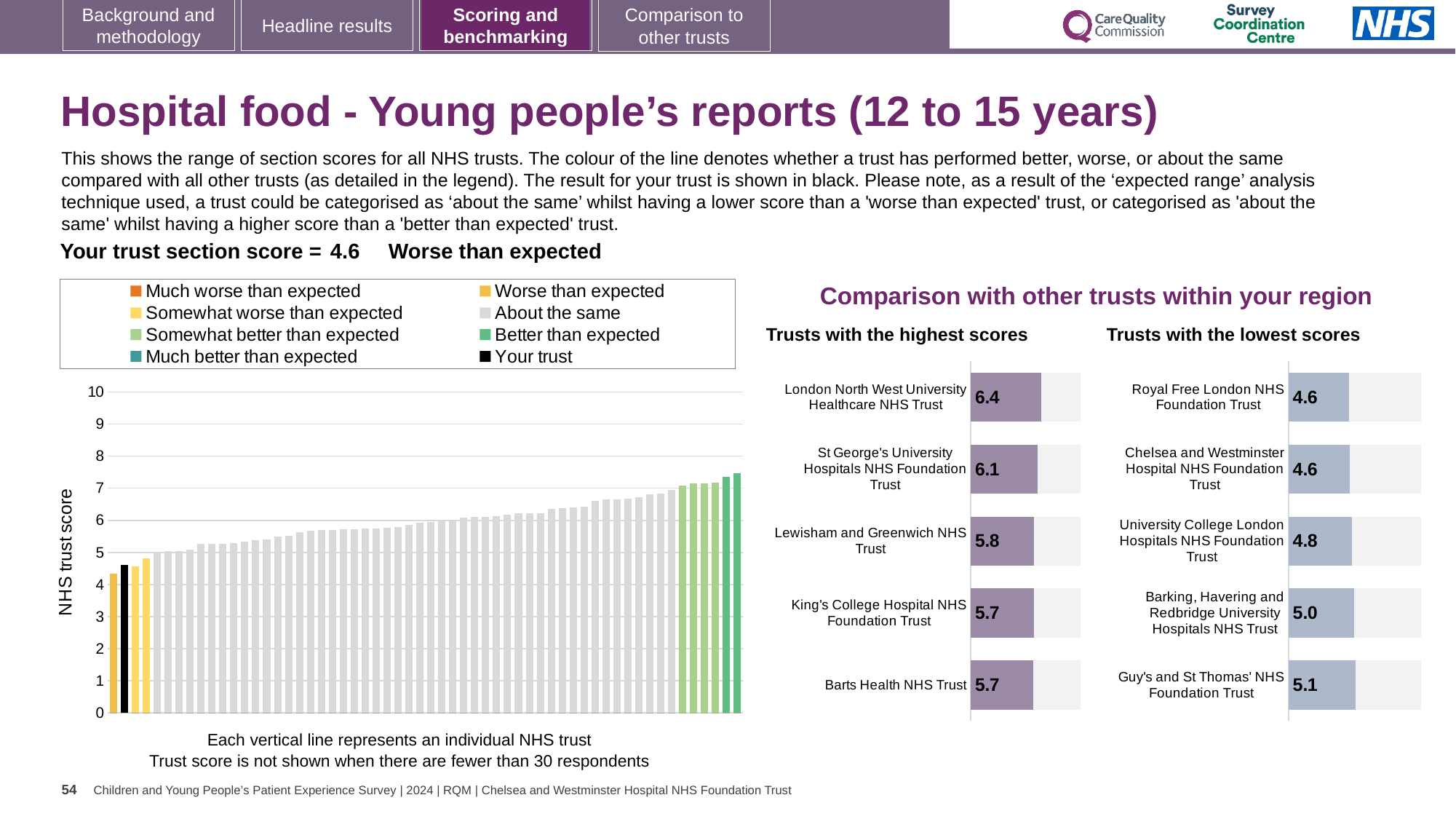
In the 'Trusts with the highest scores' chart, what is the difference between the scores of London North West University Healthcare NHS Trust and Barts Health NHS Trust? 0.7 How many entries does the legend above the NHS trust score chart list? 8 In the 'Trusts with the lowest scores' chart, what is the score for University College London Hospitals NHS Foundation Trust? 4.8 In the 'Trusts with the lowest scores' chart, what is the difference between the scores of Guy's and St Thomas' NHS Foundation Trust and Royal Free London NHS Foundation Trust? 0.5 In the 'Trusts with the highest scores' chart, what is the score for London North West University Healthcare NHS Trust? 6.4 In the NHS trust score chart on the left, is the value for the black 'Your trust' bar greater or less than 5? less In the 'Trusts with the lowest scores' chart, how many trusts are shown? 5 In the 'Trusts with the highest scores' chart, which trust has the highest score? London North West University Healthcare NHS Trust In the 'Trusts with the highest scores' chart, which has a higher score: St George's University Hospitals NHS Foundation Trust or Lewisham and Greenwich NHS Trust? St George's University Hospitals NHS Foundation Trust What kind of chart is the NHS trust score chart on the left? bar chart In the NHS trust score chart on the left, do the bar values rise or fall from left to right? rise In the 'Trusts with the lowest scores' chart, which trust has the highest score shown? Guy's and St Thomas' NHS Foundation Trust